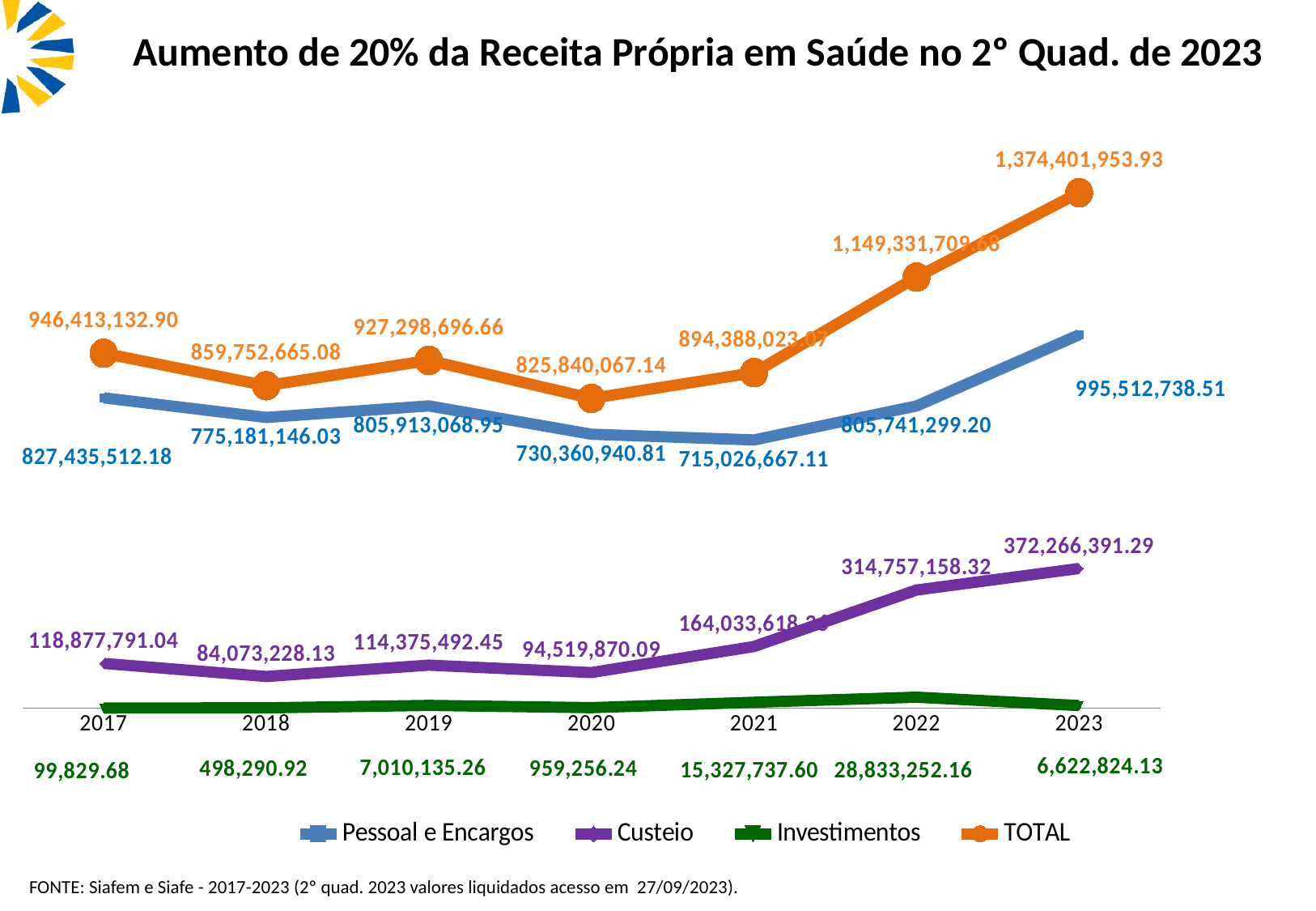
What is the value of Pessoal e Encargos in 2021? 715,026,667.11 What is the TOTAL value for 2023? 1,374,401,953.93 What is the value of Investimentos in 2019? 7,010,135.26 What is the value of Custeio in 2022? 314,757,158.32 Which is larger, the Custeio value in 2017 or in 2019? 2017 What is the difference between the Pessoal e Encargos values for 2023 and 2022? 189,771,439.31 What kind of chart is shown on the slide? line chart How many series does the legend list? 4 How many years are shown on the x axis? 7 In which year is Pessoal e Encargos lowest? 2021 In which year is the TOTAL highest? 2023 In which year is Investimentos highest? 2022